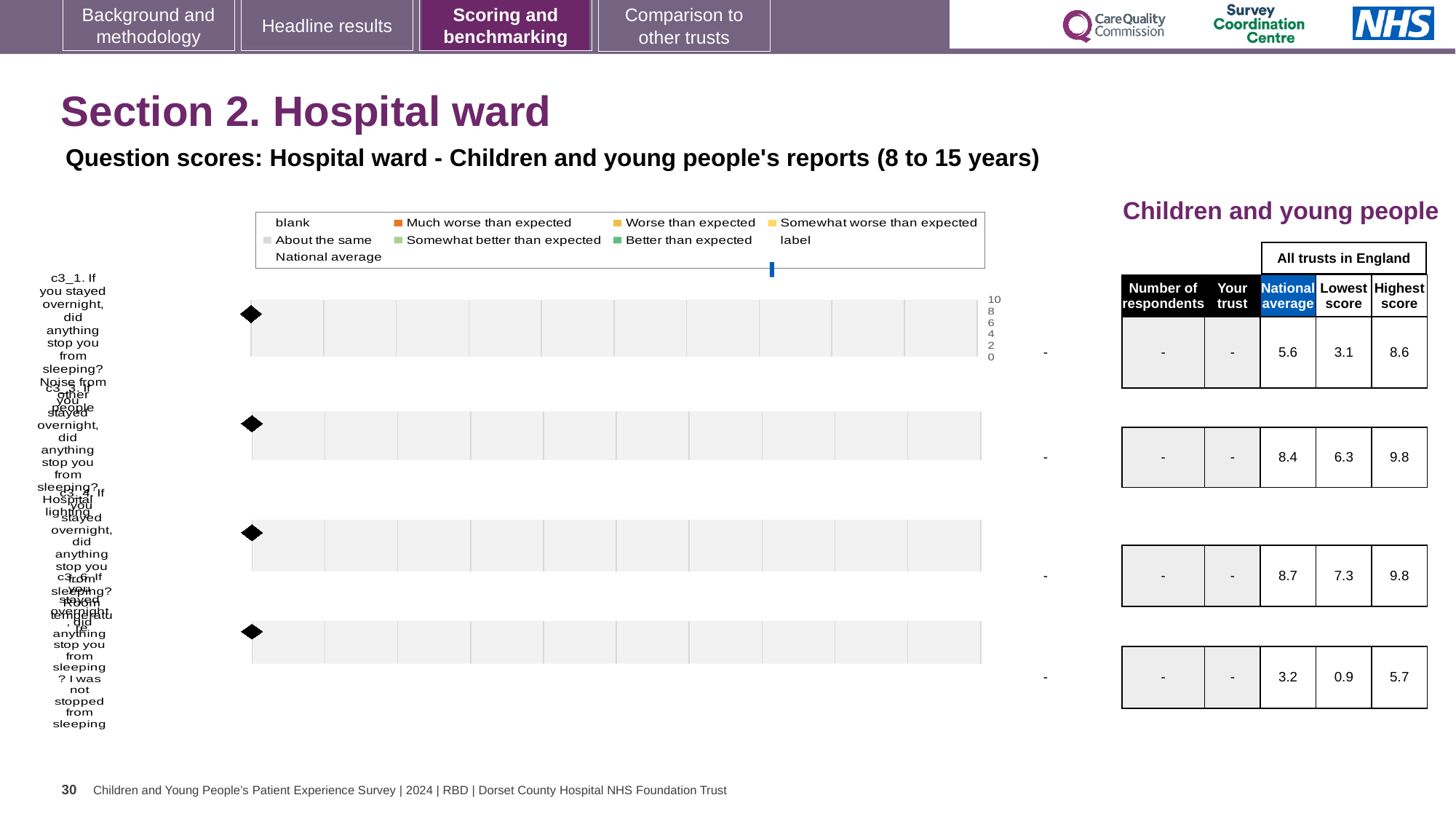
What is the maximum value shown on the chart's score axis? 10 How many question rows (categories) does the chart show? 4 Which colour does the legend use for 'Much worse than expected'? orange What kind of chart is shown on the slide? bar chart In the table beside the chart, what is the difference between the highest score and the lowest score for the first question row (c3_1)? 5.5 In the table beside the chart, what is the lowest score for the fourth question row (c3_6, I was not stopped from sleeping)? 0.9 In the table beside the chart, is the national average for the third question row (c3_4) larger or smaller than that for the second row (c3_3)? larger In the table beside the chart, what is the national average for the first question row (c3_1, noise from other people)? 5.6 In the table beside the chart, which question row has the lowest national average? c3_6 (I was not stopped from sleeping), 3.2 In the table beside the chart, which question row has the highest national average? c3_4 (room temperature), 8.7 In the table beside the chart, what is the highest score for the second question row (c3_3, hospital lighting)? 9.8